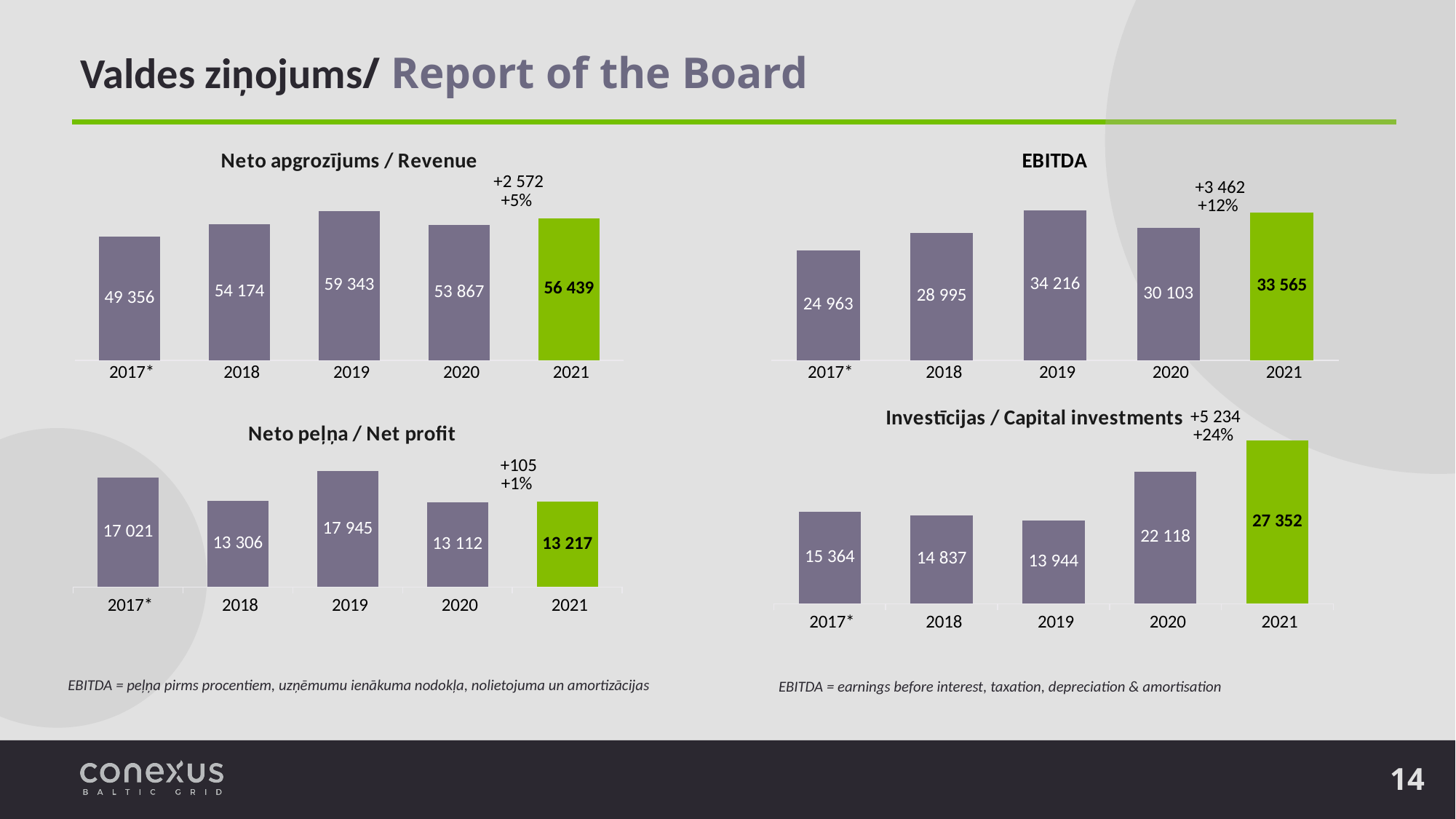
In the Investīcijas / Capital investments chart, what is the difference between the 2021 and 2020 values? 5 234 In the Investīcijas / Capital investments chart, which year has the highest value? 2021 In the EBITDA chart, which year has the lowest value? 2017* In the Investīcijas / Capital investments chart, do the values rise or fall from 2019 to 2021? rise In the Neto apgrozījums / Revenue chart, what is the difference between the 2021 and 2020 values? 2 572 In the Neto peļņa / Net profit chart, which is larger, the value for 2017* or the value for 2019? 2019 What kind of chart is the Neto peļņa / Net profit chart? bar chart In the EBITDA chart, what is the value for 2021? 33 565 In the Neto peļņa / Net profit chart, what is the value for 2020? 13 112 In the Neto apgrozījums / Revenue chart, what colour is the 2021 bar? green In the Neto apgrozījums / Revenue chart, what is the value for 2019? 59 343 How many years are shown in the EBITDA chart? 5